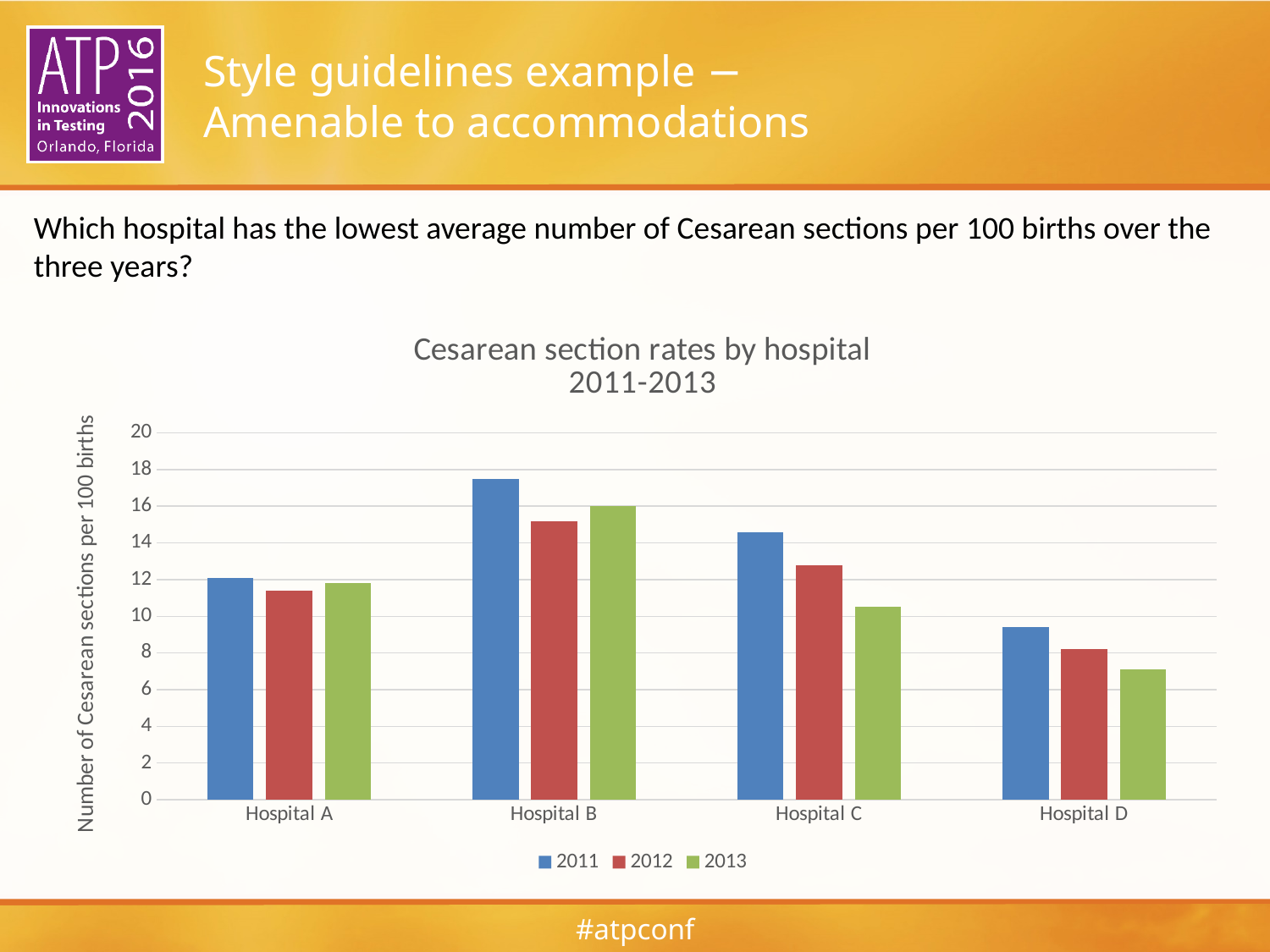
Is the 2013 value for Hospital D greater or less than 8? less How many series does the chart legend list? 3 Is the 2012 value for Hospital C greater or less than 12? greater What is the label of the vertical axis? Number of Cesarean sections per 100 births Which hospital has the highest 2011 value? Hospital B What kind of chart is shown on the slide? bar chart Which is larger for Hospital C: the 2011 value or the 2013 value? 2011 How many hospitals are shown on the x axis of the chart? 4 Is the 2011 value for Hospital B greater or less than 16? greater Do the values for Hospital D rise or fall from 2011 to 2013? fall Which hospital has the lowest 2013 value? Hospital D What is the title of the chart? Cesarean section rates by hospital 2011-2013